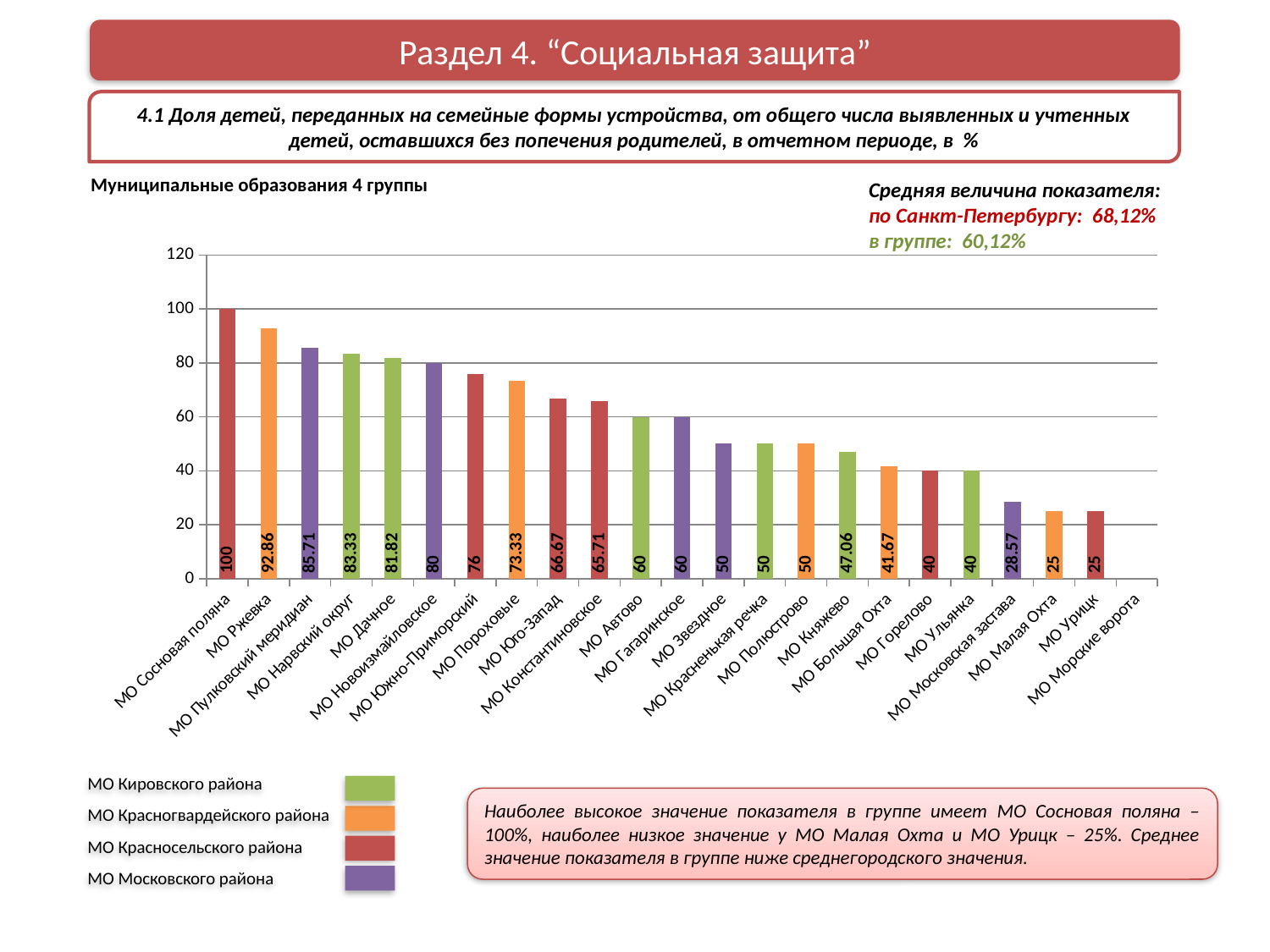
What is the value for МО Ржевка? 92.86 What is the value for МО Пороховые? 73.33 What is the difference between the values for МО Юго-Запад and МО Константиновское? 0.96 Which is larger, the value for МО Дачное or the value for МО Новоизмайловское? МО Дачное What is the difference between the values for МО Сосновая поляна and МО Ржевка? 7.14 Do the values generally rise or fall from left to right along the x axis? fall How many district groups are listed in the colour legend below the chart? 4 What is the average value of the indicator for Saint Petersburg stated on the slide? 68,12% Which municipality has the highest value in the chart? МО Сосновая поляна What type of chart is shown on the slide? bar chart What is the value for МО Княжево? 47.06 What is the value for МО Московская застава? 28.57